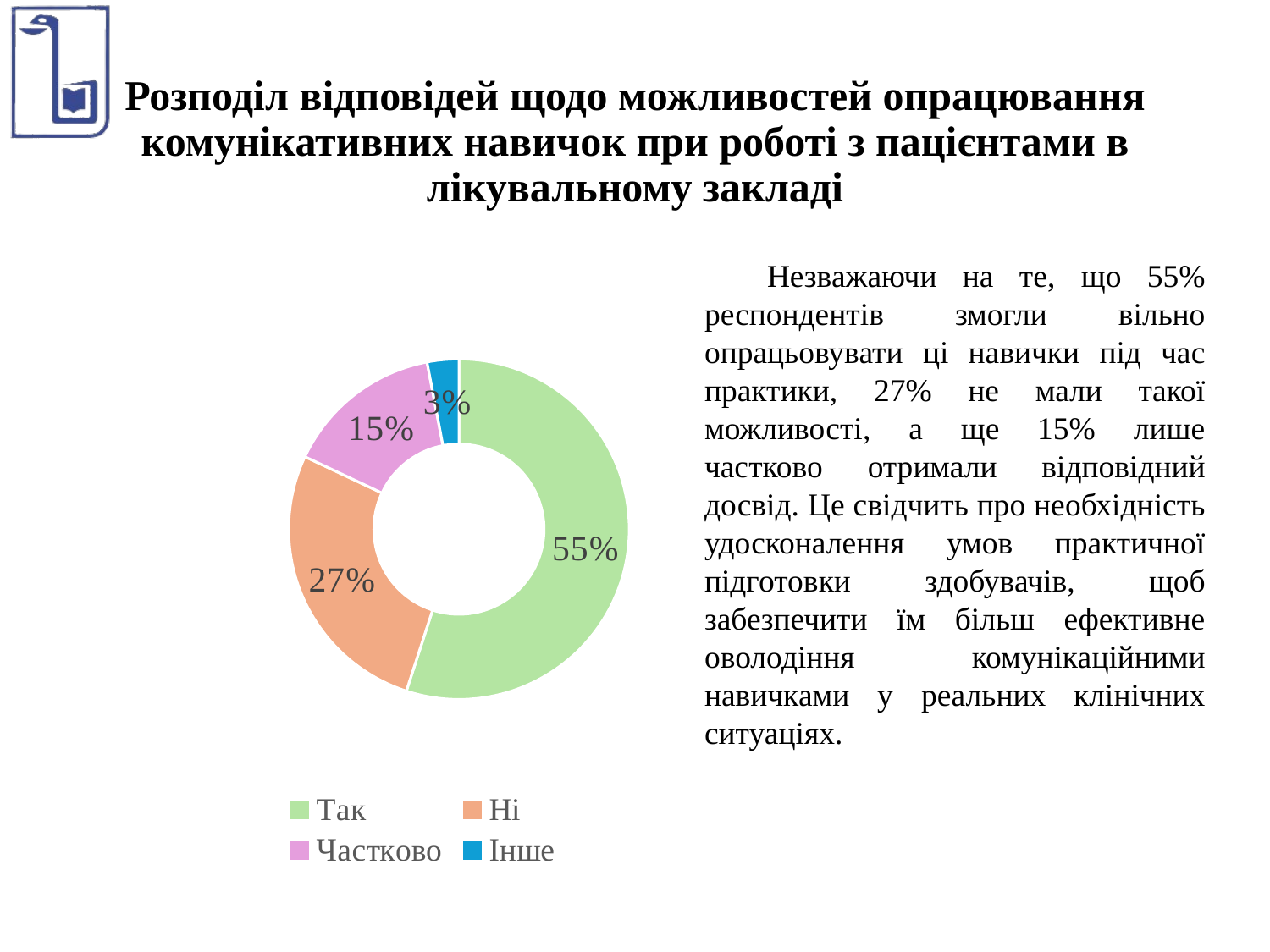
What share of responses is labelled "Інше"? 3% What share of responses is labelled "Так"? 55% What kind of chart is shown on the slide? Doughnut (pie) chart What colour is the "Інше" segment? Blue What is the difference in percentage points between "Так" and "Ні"? 28 Which category has the smallest share of the chart? Інше Which category has the largest share of the chart? Так What colour is the "Так" segment? Green What share of responses is labelled "Частково"? 15% Which is larger, the share for "Ні" or the share for "Частково"? Ні How many categories does the legend list? 4 What share of responses is labelled "Ні"? 27%